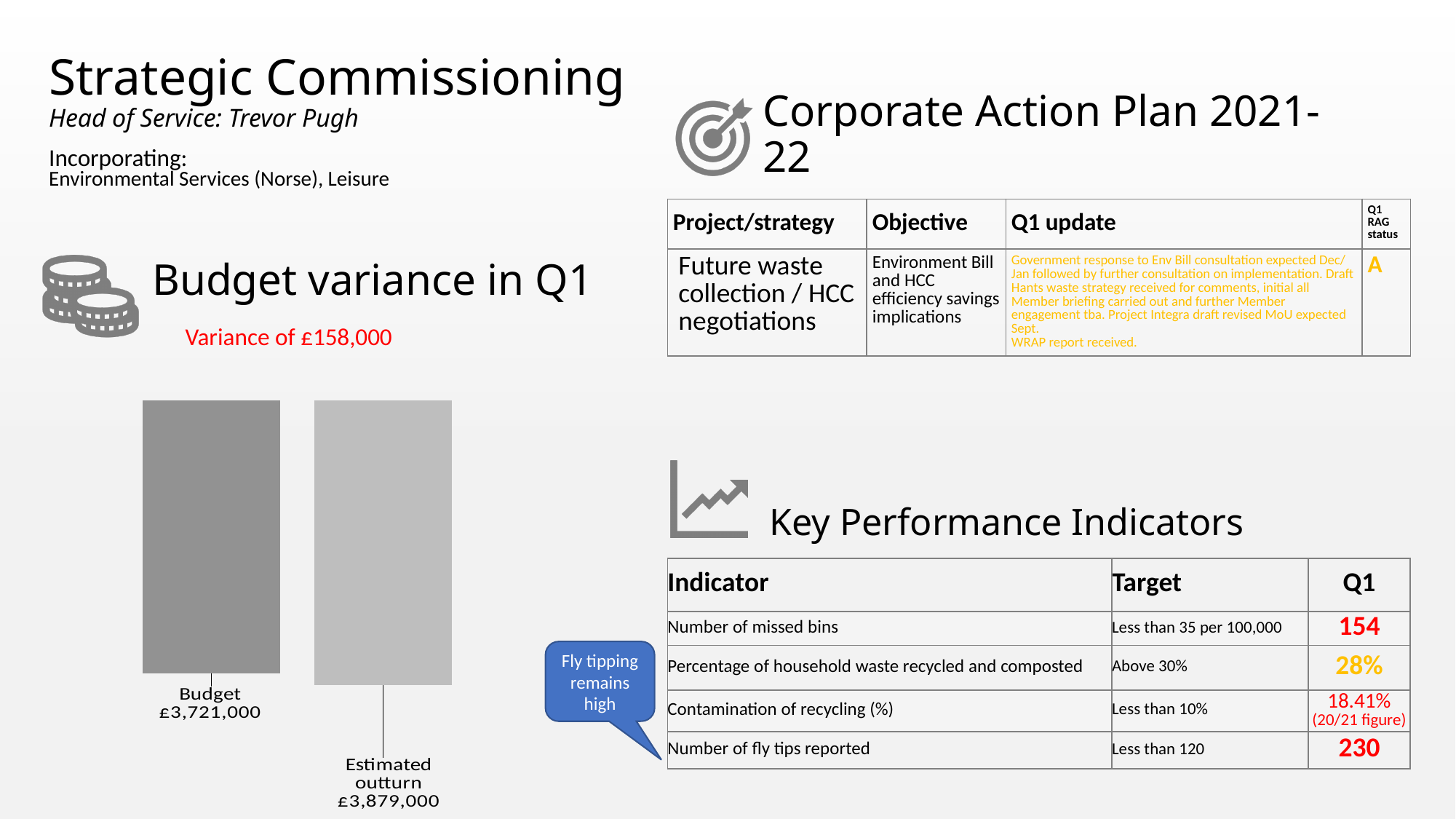
Which bar is higher in the Budget variance in Q1 chart, Budget or Estimated outturn? Estimated outturn What is the value of the Budget bar in the Budget variance in Q1 chart? £3,721,000 How many bars are shown in the Budget variance in Q1 chart? 2 What is the difference between the Estimated outturn and the Budget in the Budget variance in Q1 chart? £158,000 What is the value of the Estimated outturn bar in the Budget variance in Q1 chart? £3,879,000 Which category has the highest value in the Budget variance in Q1 chart? Estimated outturn What type of chart is used to show the Budget variance in Q1? Bar chart What are the two category labels on the Budget variance in Q1 chart? Budget and Estimated outturn Do the values rise or fall from the Budget bar to the Estimated outturn bar in the Budget variance in Q1 chart? Rise What is the title of the chart on the left of the slide? Budget variance in Q1 Which category has the lowest value in the Budget variance in Q1 chart? Budget